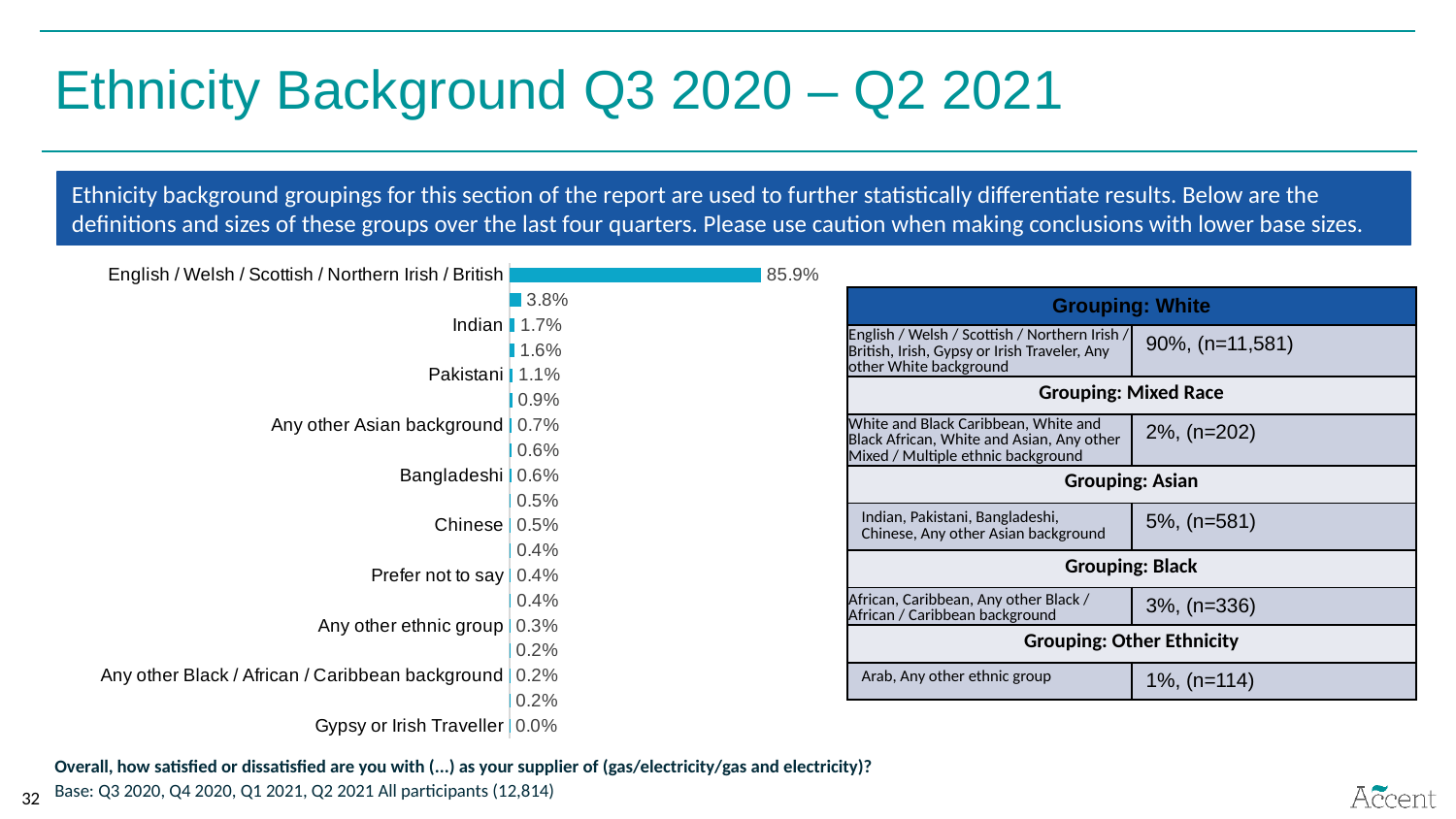
What is the value for English / Welsh / Scottish / Northern Irish / British? 85.9% What is the value for Pakistani? 1.1% What is the value for Prefer not to say? 0.4% How many bars are plotted in the chart? 19 What is the value for Gypsy or Irish Traveller? 0.0% Which category has the highest value? English / Welsh / Scottish / Northern Irish / British What is the difference between the values for Indian and Pakistani? 0.6% What is the value for Indian? 1.7% Which is larger, the value for Chinese or the value for Any other Asian background? Any other Asian background What kind of chart is shown on the slide? bar chart Which labelled category has the lowest value? Gypsy or Irish Traveller What is the value for Bangladeshi? 0.6%